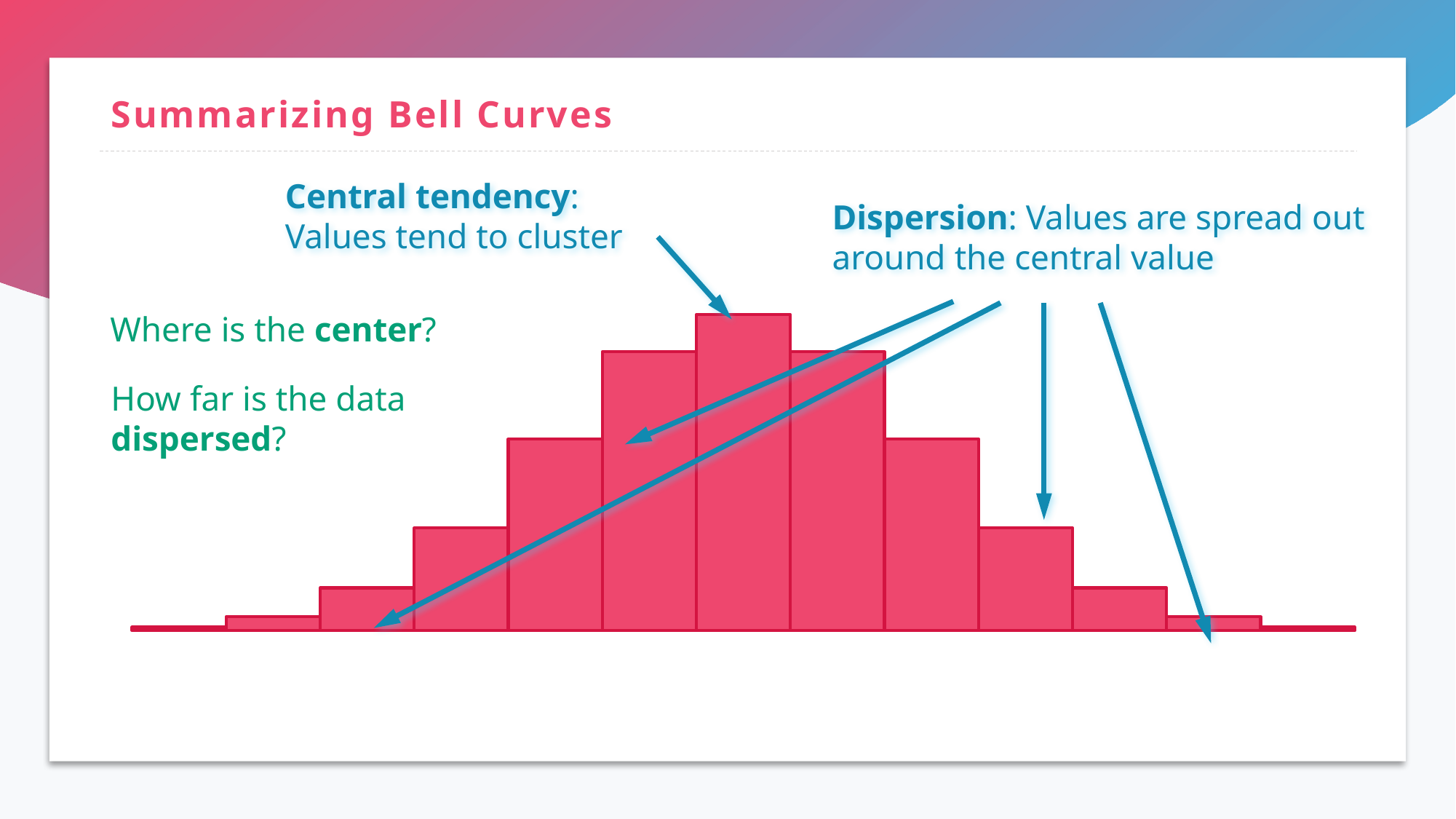
Which bar is the tallest in the chart? the middle bar Do the bar heights rise or fall moving from the leftmost bar toward the middle of the chart? rise Which bars are the shortest in the chart? the leftmost and rightmost bars What colour are the bars in the chart? red/pink What is the title of the slide containing the chart? Summarizing Bell Curves Do the bar heights rise or fall moving from the middle of the chart toward the rightmost bar? fall What kind of chart is shown on the slide? bar chart Which is taller, the leftmost bar or the middle bar? the middle bar Which is taller, the second bar from the left or the fourth bar from the left? the fourth bar from the left